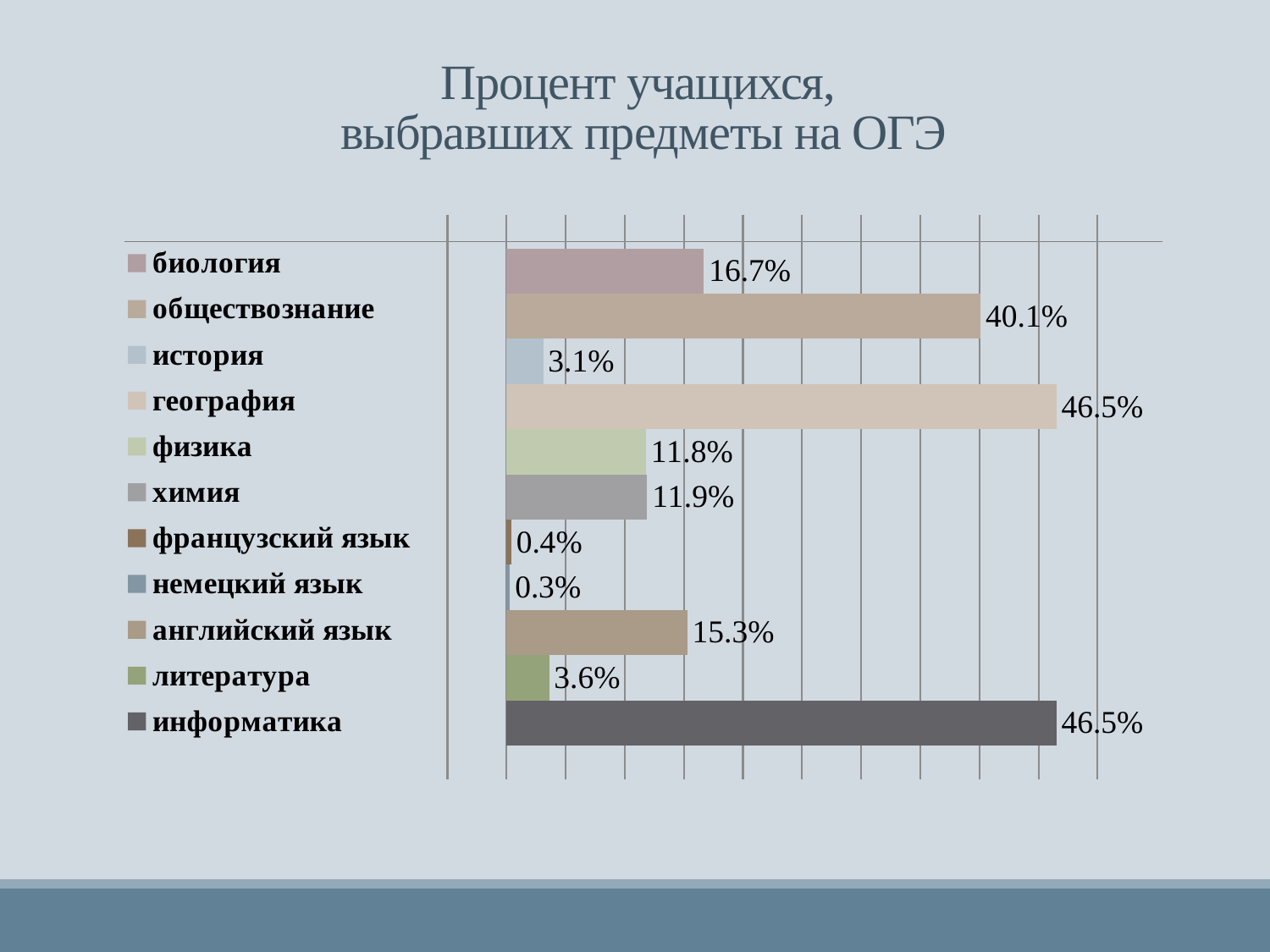
What percentage of students chose обществознание? 40.1% How many subjects are shown in the chart? 11 Which subject has the lowest percentage? немецкий язык What is the title of the chart? Процент учащихся, выбравших предметы на ОГЭ What percentage is shown for английский язык? 15.3% Which is larger, the value for обществознание or the value for география? география What is the value for история? 3.1% What kind of chart is shown on the slide? bar chart Which is larger, the value for английский язык or the value for литература? английский язык What is the value shown for биология? 16.7% What is the difference between the values for обществознание and биология? 23.4% What is the difference between the values for химия and физика? 0.1%